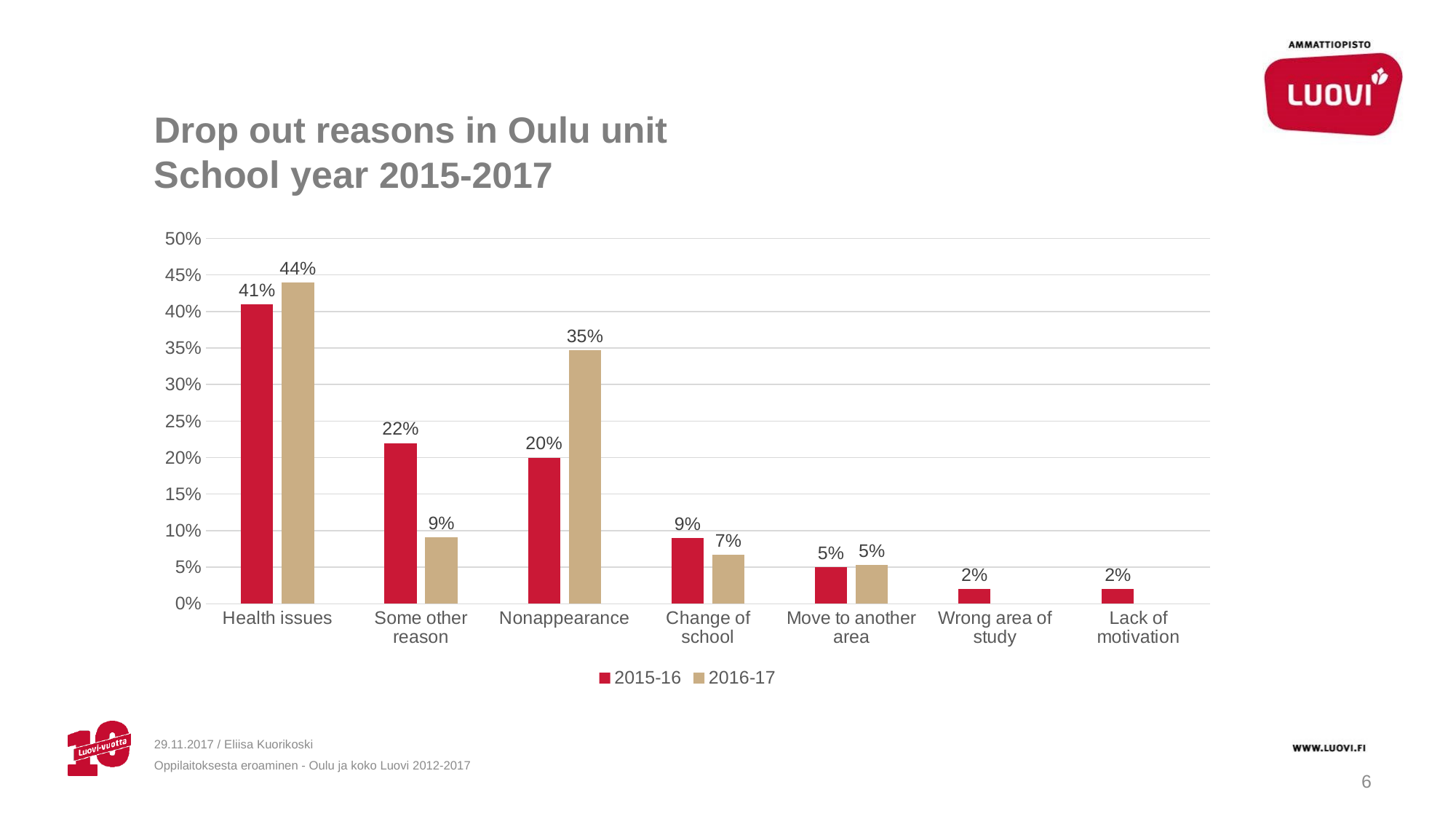
Which category has the highest value in the 2016-17 series? Health issues How many series does the legend list? 2 Which is larger for Some other reason: the 2015-16 value or the 2016-17 value? 2015-16 What is the difference between the 2016-17 and 2015-16 values for Nonappearance? 15% Which category has the lowest value in the 2015-16 series? Wrong area of study and Lack of motivation (2%) What is the value for Health issues in 2015-16? 41% What kind of chart is shown on the slide? Bar chart What is the value for Nonappearance in 2016-17? 35% What is the value for Some other reason in 2016-17? 9% What is the difference between the 2015-16 and 2016-17 values for Health issues? 3% How many categories are shown on the x axis? 7 What is the title of the chart on the slide? Drop out reasons in Oulu unit School year 2015-2017